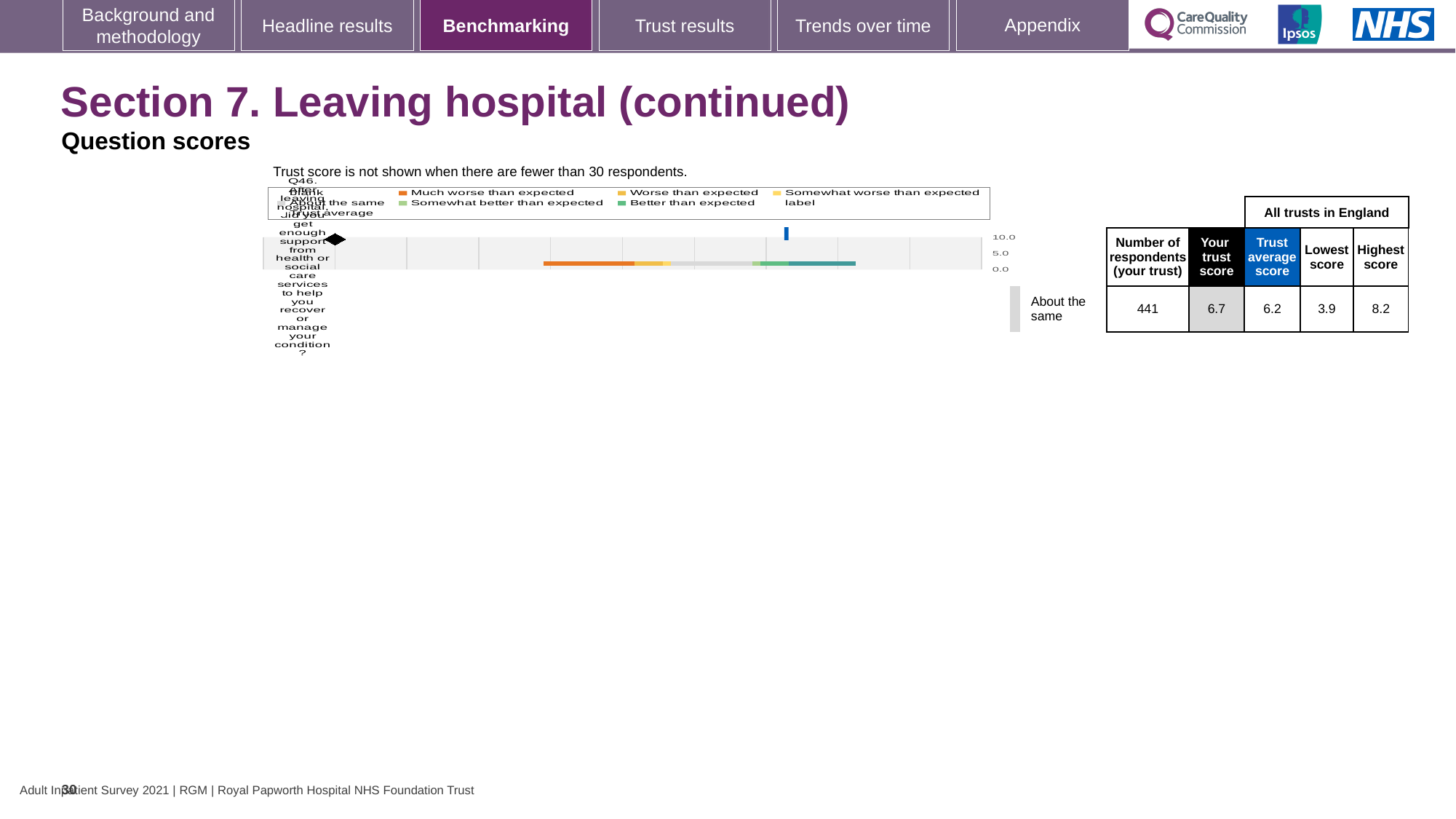
What is the number of respondents for your trust shown for Q46? 441 What benchmarking category is your trust's Q46 score placed in? About the same What is the maximum value shown on the chart's axis? 10.0 What is the trust average score for Q46? 6.2 What is the difference between the highest and lowest scores among all trusts in England for Q46? 4.3 Is your trust score for Q46 greater or less than 5.0 on the chart axis? greater What is the lowest score among all trusts in England for Q46? 3.9 What kind of chart is used to show the Q46 benchmarking result? bar chart Is your trust score for Q46 higher or lower than the trust average score? higher What is your trust score for Q46 about getting enough support from health or social care services after leaving hospital? 6.7 What is the highest score among all trusts in England for Q46? 8.2 What is the difference between your trust score and the trust average score for Q46? 0.5